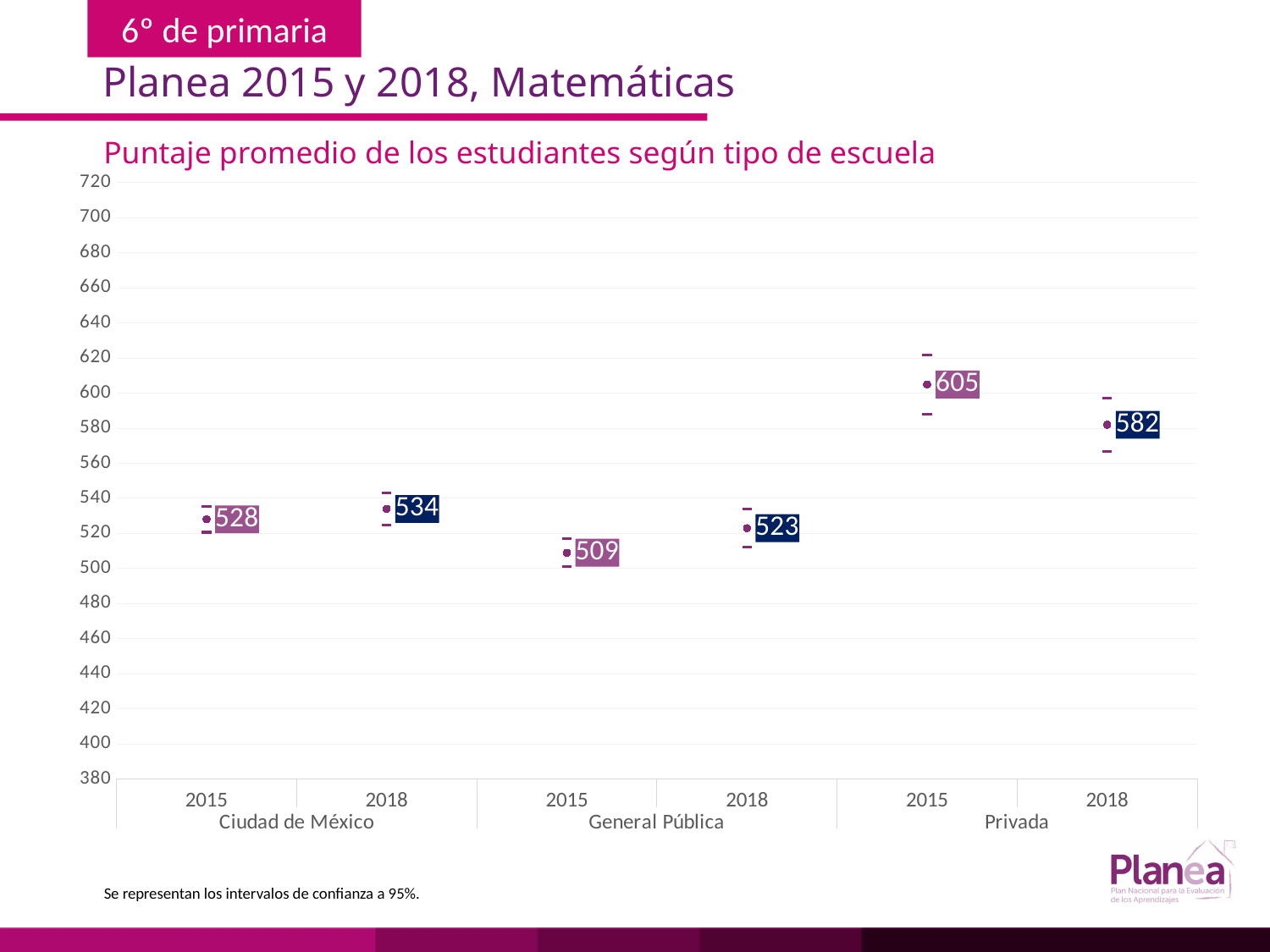
What is the average score for Privada in 2015? 605 What is the difference between the Privada scores in 2015 and 2018? 23 What is the title of the chart? Puntaje promedio de los estudiantes según tipo de escuela What is the average score for Ciudad de México in 2015? 528 Did the Ciudad de México average score rise or fall from 2015 to 2018? rise How many data points are plotted on the chart? 6 Which is larger, the General Pública score in 2015 or in 2018? 2018 Did the Privada average score rise or fall from 2015 to 2018? fall Which school type and year has the highest average score? Privada 2015 Which school type and year has the lowest average score? General Pública 2015 What is the difference between the Ciudad de México scores in 2018 and 2015? 6 What is the average score for General Pública in 2018? 523